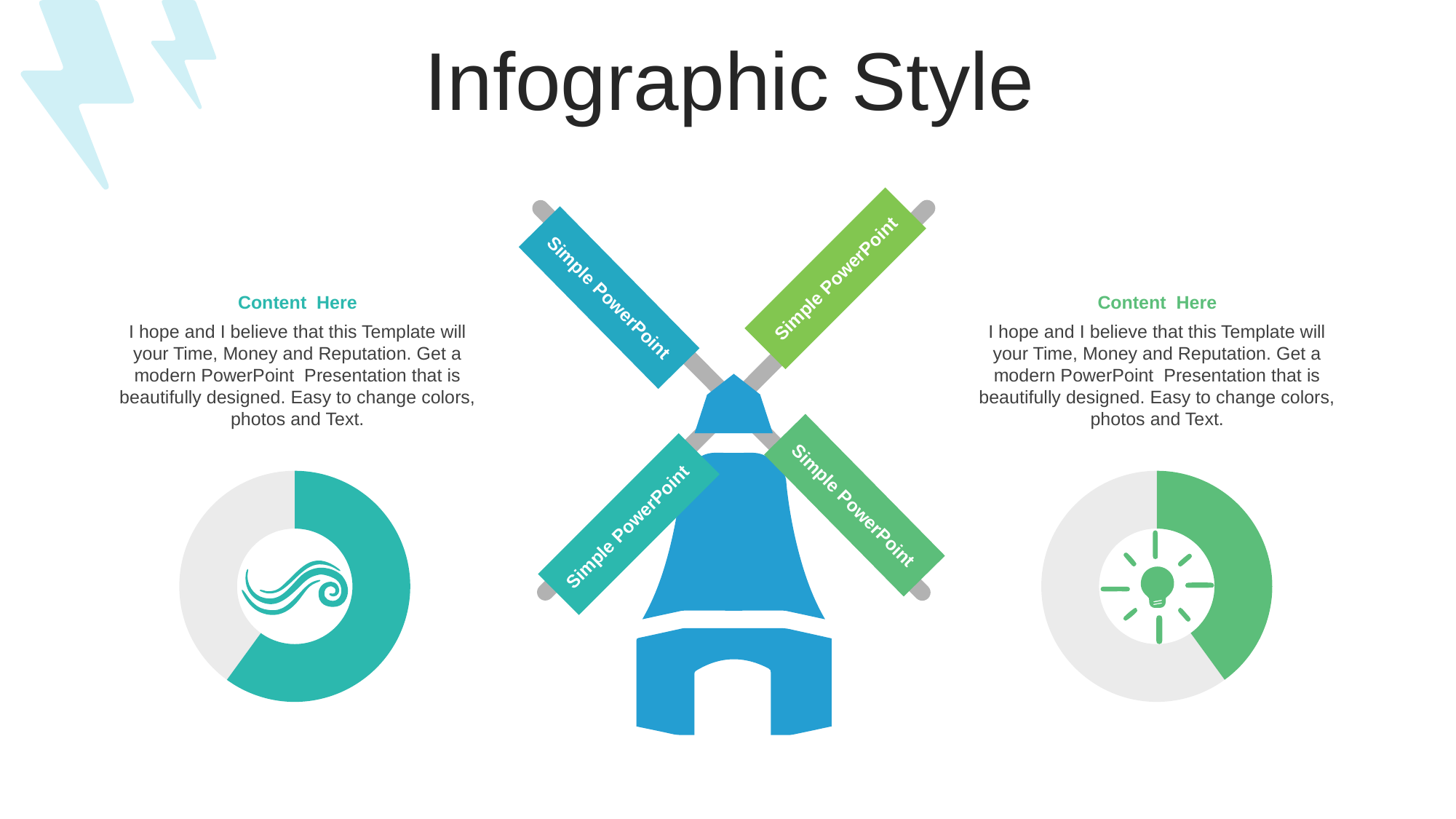
In the right doughnut chart, which slice is the largest? Grey In the left doughnut chart, how many slices are there? 2 In the left doughnut chart, which slice is larger, the teal slice or the grey slice? Teal In the left doughnut chart, which slice is the smallest? Grey What icon appears in the centre of the right doughnut chart? A light bulb How many doughnut charts are on the slide? 2 What kind of chart is shown on the left side of the slide, below the left 'Content Here' text? Doughnut chart What colour is the coloured (non-grey) slice of the left doughnut chart? Teal In the right doughnut chart, how many slices are there? 2 In the right doughnut chart, which slice is larger, the green slice or the grey slice? Grey What kind of chart is shown on the right side of the slide, below the right 'Content Here' text? Doughnut chart